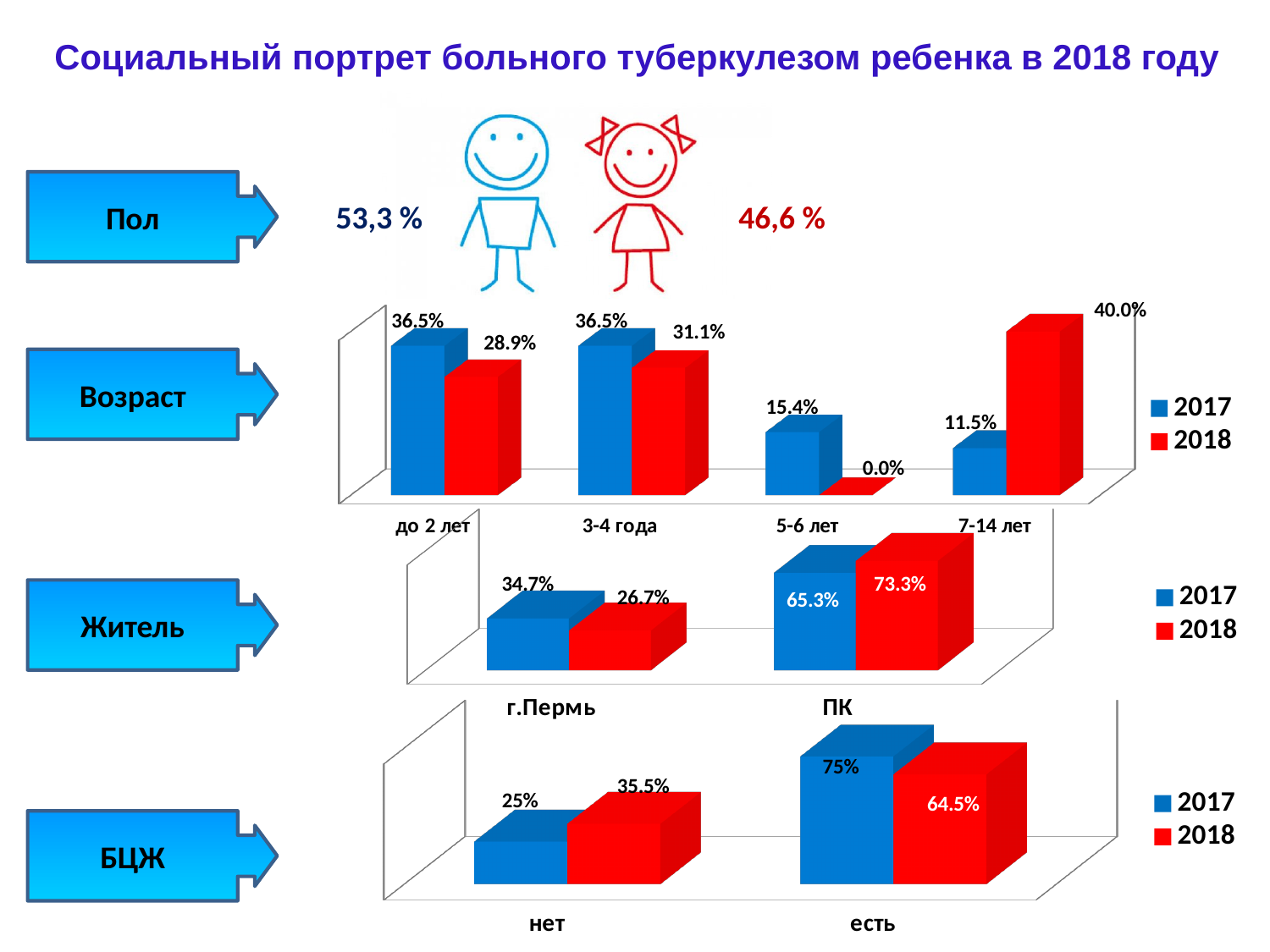
In the resident chart (Житель), what is the 2018 value for ПК? 73.3% In the BCG chart (БЦЖ), what is the difference between the 2018 and 2017 values for нет? 10.5% In the age chart (Возраст), how many age categories are shown? 4 In the BCG chart (БЦЖ), what is the 2017 value for есть? 75% In the resident chart (Житель), which is larger: the 2017 value for г.Пермь or the 2017 value for ПК? ПК In the age chart (Возраст), what is the 2018 value for 7-14 лет? 40.0% In the age chart (Возраст), which category has the lowest 2018 value? 5-6 лет In the age chart (Возраст), what is the difference between the 2017 and 2018 values for до 2 лет? 7.6% How many series does the legend of the BCG chart (БЦЖ) list? 2 In the age chart (Возраст), which category has the highest 2018 value? 7-14 лет What type of chart is the age chart (Возраст)? Bar chart In the age chart (Возраст), what is the 2017 value for 5-6 лет? 15.4%